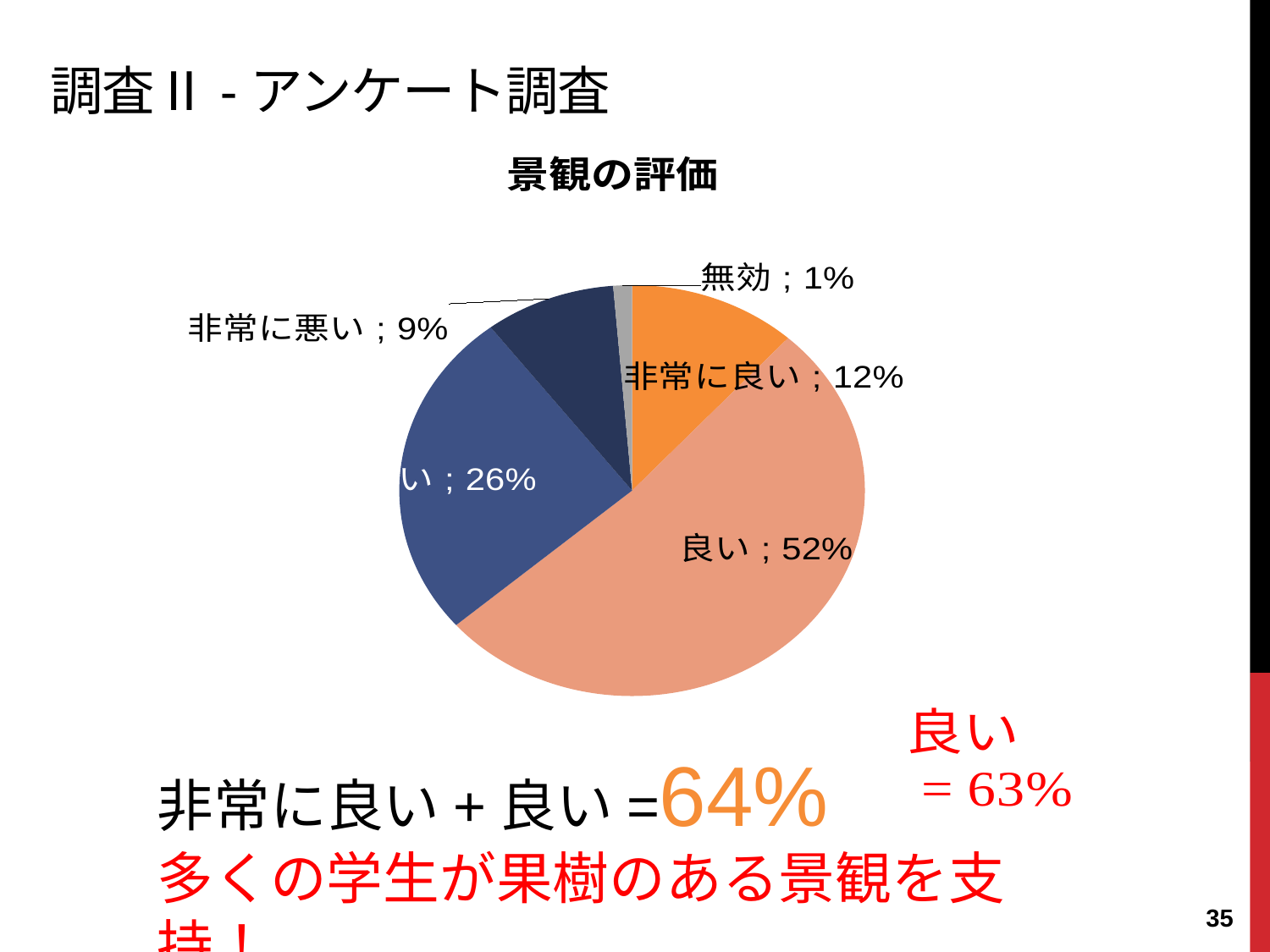
What percentage of the pie is 非常に良い? 12% What percentage of the pie is 非常に悪い? 9% How many slices does the pie chart have? 5 Which is larger, the slice for 非常に良い or the slice for 非常に悪い? 非常に良い What is the difference in percentage points between 良い and 非常に良い? 40% Which category has the largest slice of the pie? 良い What is the combined share of 非常に良い and 良い? 64% What percentage of the pie is 良い? 52% What kind of chart is shown on the slide? pie chart What percentage of the pie is 無効? 1% What is the title of the chart? 景観の評価 Which category has the smallest slice of the pie? 無効